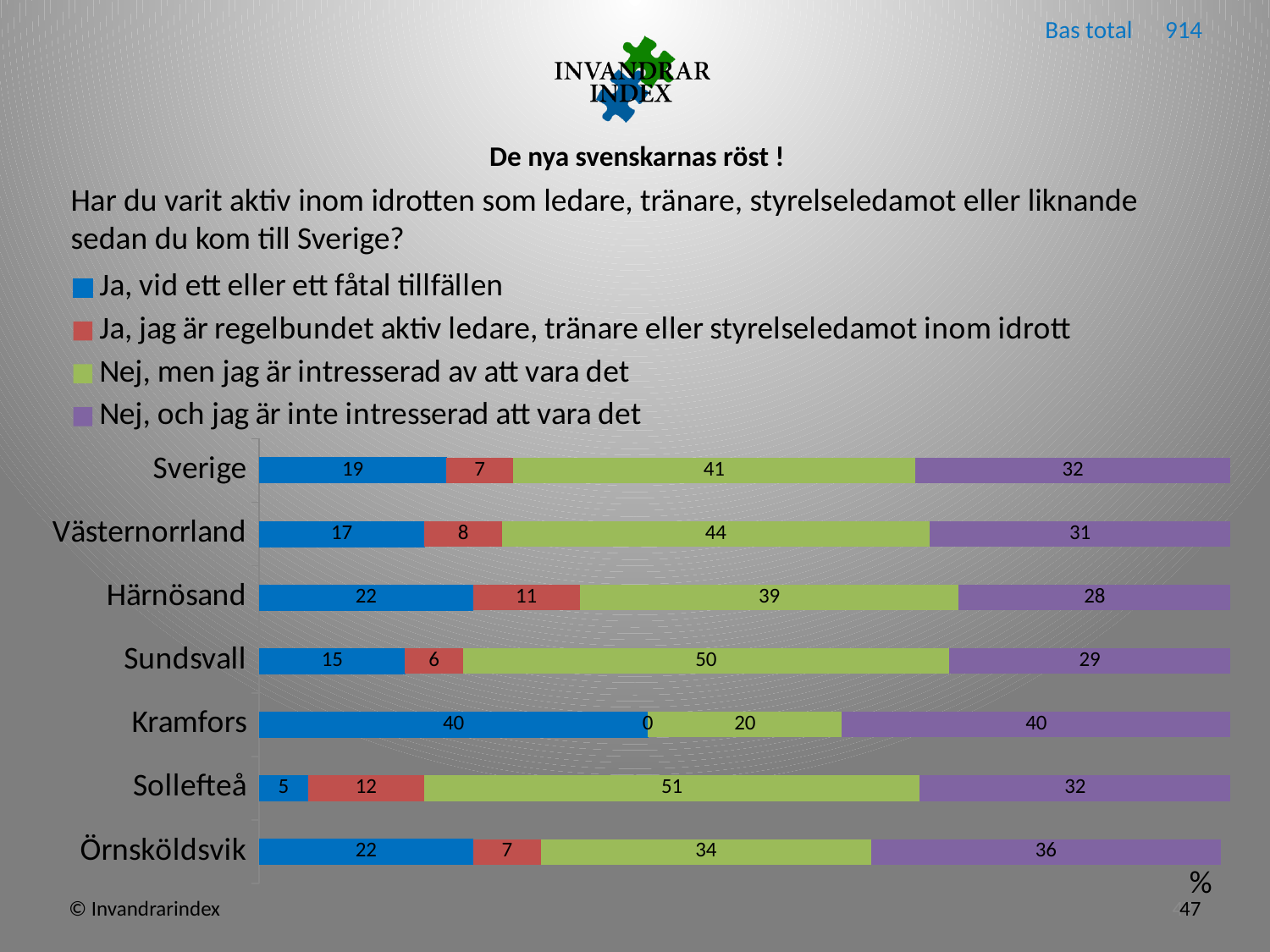
How many categories (regions) are shown in the chart? 7 Which has the larger value in the series "Nej, men jag är intresserad av att vara det": Västernorrland or Örnsköldsvik? Västernorrland What kind of chart is shown on the slide? Stacked bar chart What is the difference between Sverige and Härnösand in the series "Nej, och jag är inte intresserad att vara det"? 4 What is the value for Sundsvall in the series "Nej, men jag är intresserad av att vara det"? 50 What is the value for Kramfors in the series "Ja, vid ett eller ett fåtal tillfällen"? 40 How many series does the legend list? 4 Which category has the highest value in the series "Ja, jag är regelbundet aktiv ledare, tränare eller styrelseledamot inom idrott"? Sollefteå What colour represents the series "Nej, och jag är inte intresserad att vara det"? Purple What is the total of the stacked bar for Sverige? 99 What is the value for Kramfors in the series "Ja, jag är regelbundet aktiv ledare, tränare eller styrelseledamot inom idrott"? 0 Which category has the lowest value in the series "Ja, vid ett eller ett fåtal tillfällen"? Sollefteå